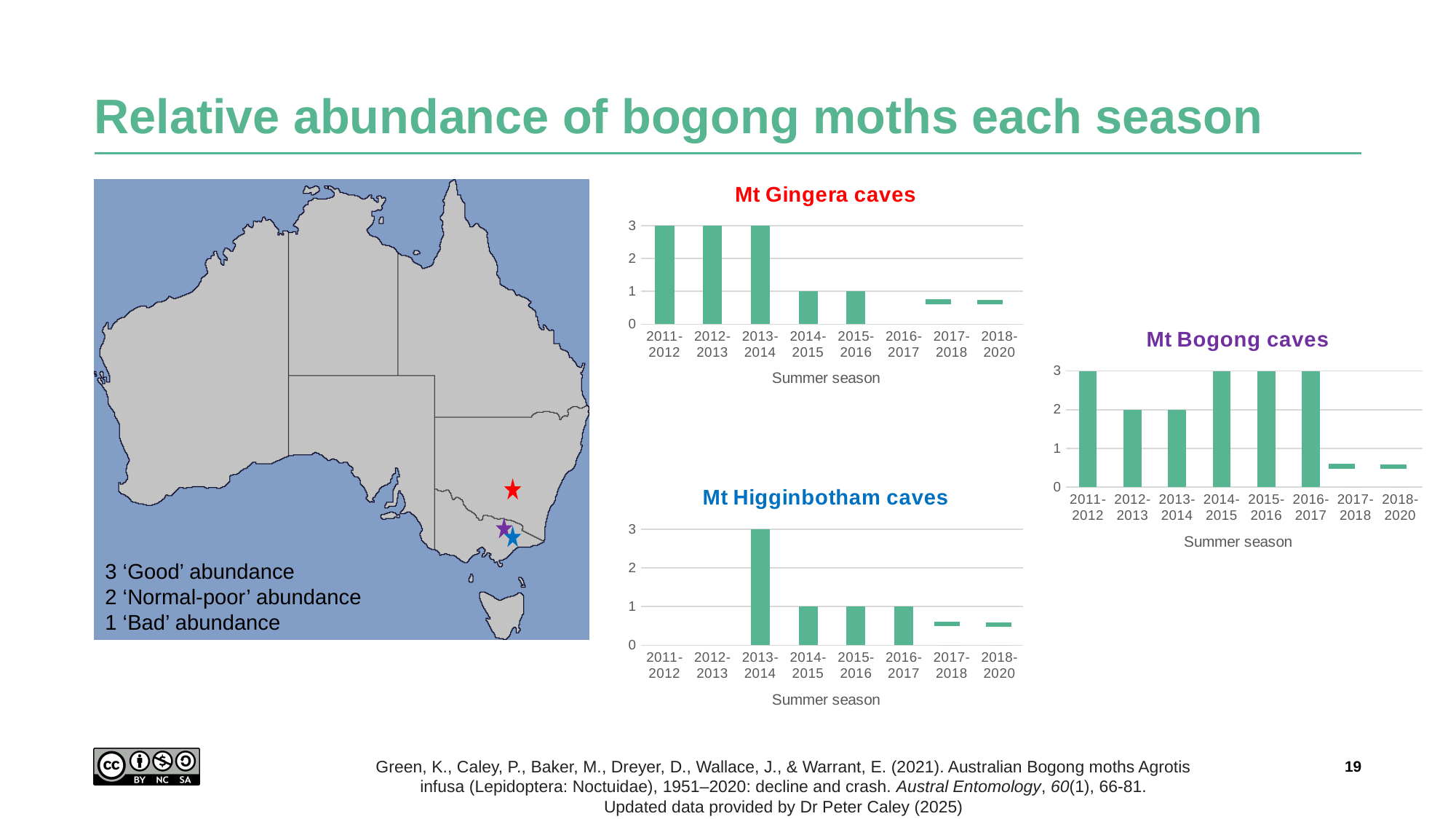
How many summer seasons are shown on the x axis of the Mt Bogong caves chart? 8 What kind of chart is the Mt Higginbotham caves chart? bar chart In the Mt Gingera caves chart, what is the difference between the values for 2012-2013 and 2015-2016? 2 In the Mt Higginbotham caves chart, which summer season has the highest abundance value? 2013-2014 What is the x-axis label of the Mt Gingera caves chart? Summer season In the Mt Gingera caves chart, what is the abundance value for the 2011-2012 summer season? 3 In the Mt Higginbotham caves chart, what is the abundance value for the 2013-2014 summer season? 3 In the Mt Bogong caves chart, which is larger: the value for 2013-2014 or the value for 2014-2015? 2014-2015 In the Mt Gingera caves chart, what is the abundance value for the 2014-2015 summer season? 1 In the Mt Gingera caves chart, is the value for the 2013-2014 summer season greater or less than 2? greater In the Mt Bogong caves chart, is the value for the 2017-2018 summer season greater or less than 1? less In the Mt Bogong caves chart, what is the abundance value for the 2012-2013 summer season? 2